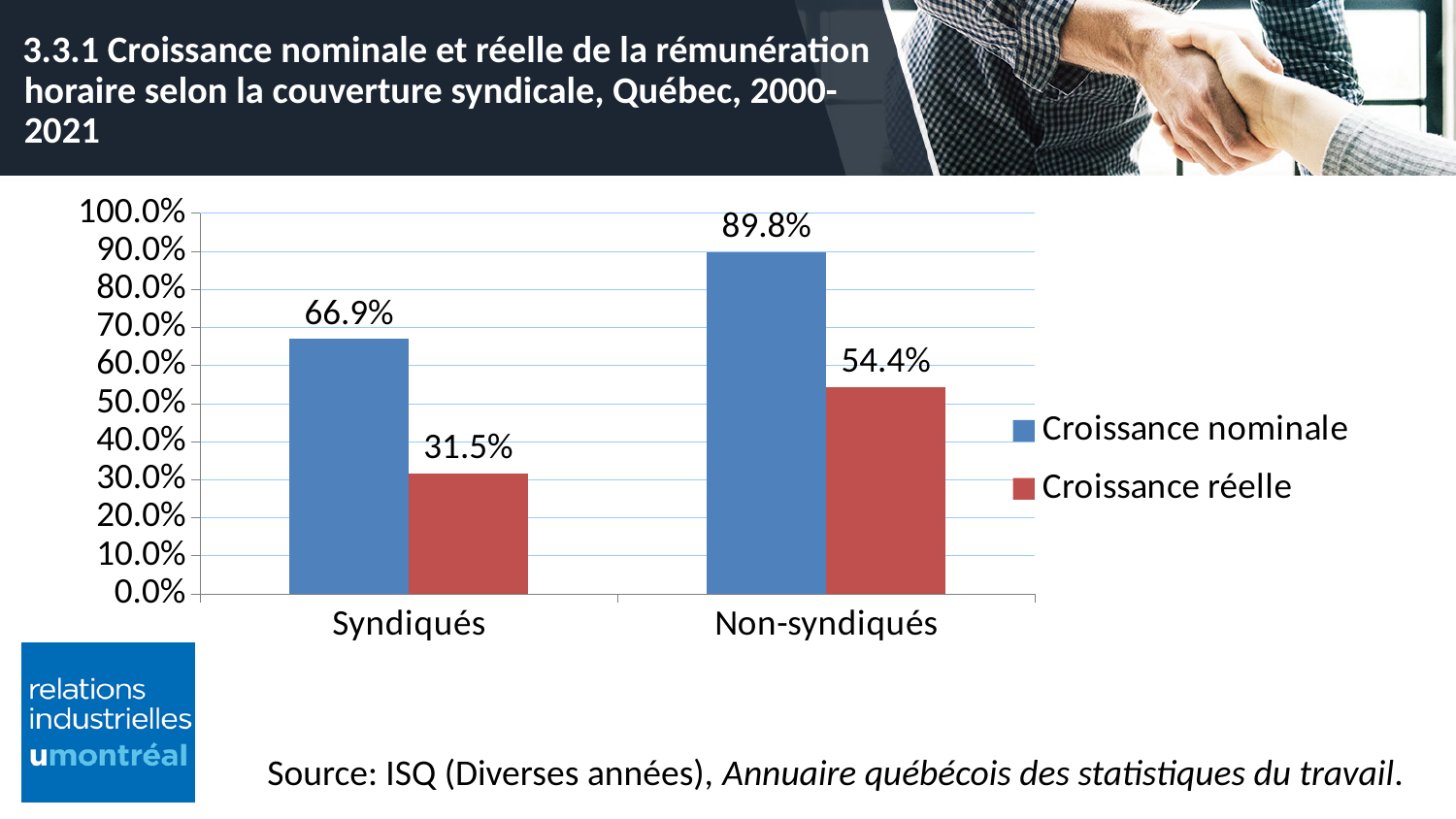
What is the difference in Croissance nominale between Non-syndiqués and Syndiqués? 22.9% What is the difference between Croissance nominale and Croissance réelle for Non-syndiqués? 35.4% How many series does the legend list? 2 Is the Croissance nominale value for Non-syndiqués greater or less than 80.0%? greater What is the Croissance nominale value for Syndiqués? 66.9% Which is larger: Croissance réelle for Non-syndiqués or Croissance nominale for Syndiqués? Croissance nominale for Syndiqués Which category has the lowest Croissance réelle? Syndiqués What is the Croissance réelle value for Syndiqués? 31.5% What kind of chart is shown on the slide? bar chart How many categories are shown on the x axis? 2 What is the Croissance réelle value for Non-syndiqués? 54.4% Which category has the highest Croissance nominale? Non-syndiqués